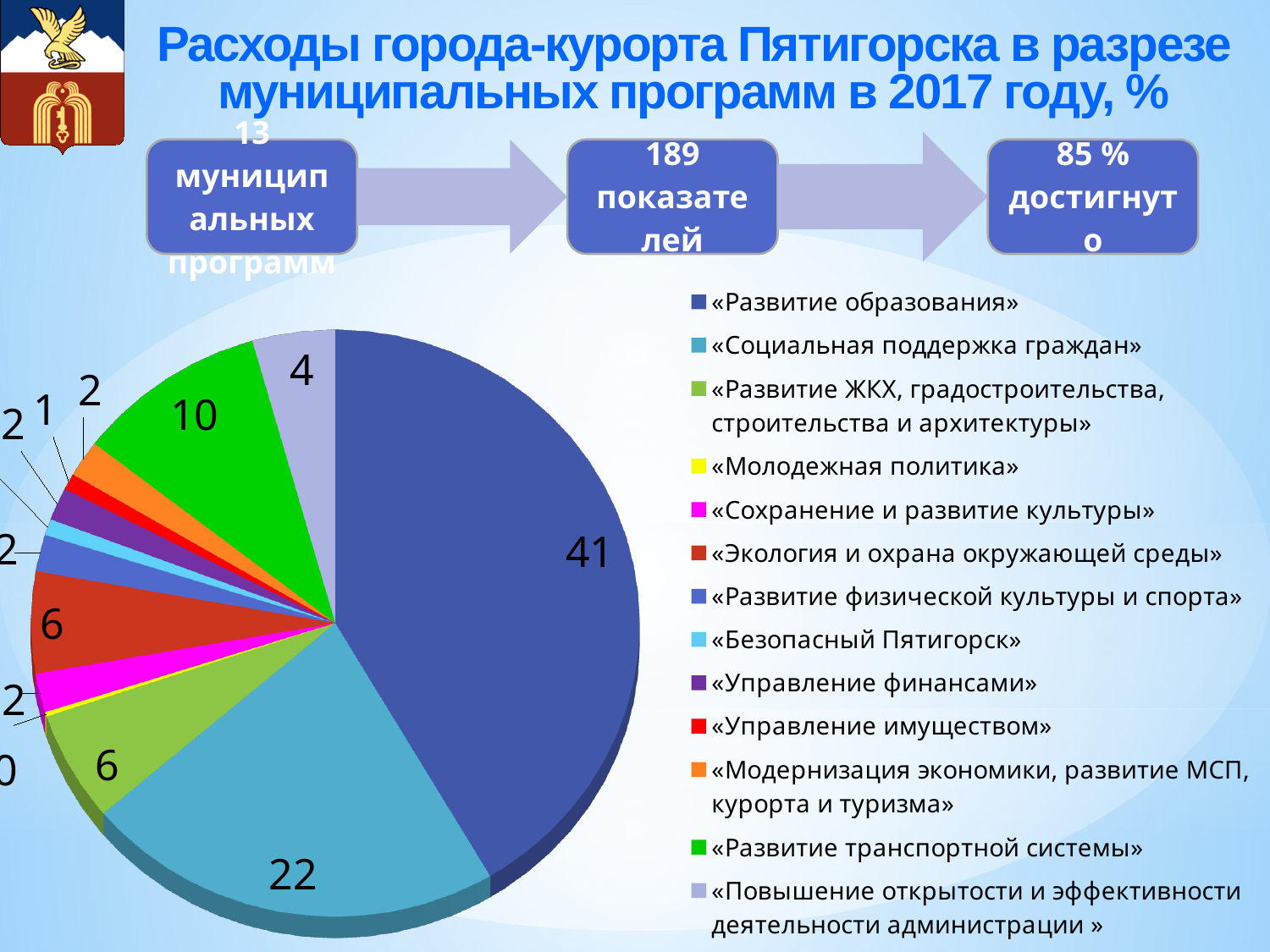
What is the value for «Развитие транспортной системы»? 10 What is the value for «Управление имуществом»? 1 What is the value for «Развитие образования»? 41 What is the value for «Повышение открытости и эффективности деятельности администрации»? 4 Which program has the largest share of the pie? «Развитие образования» What colour is the slice for «Развитие транспортной системы»? green What kind of chart is shown on the slide? pie chart How many programs are listed in the chart legend? 13 What is the difference between the values for «Развитие образования» and «Социальная поддержка граждан»? 19 What is the value for «Социальная поддержка граждан»? 22 Which is larger: the value for «Социальная поддержка граждан» or for «Развитие транспортной системы»? «Социальная поддержка граждан» What is the value for «Экология и охрана окружающей среды»? 6